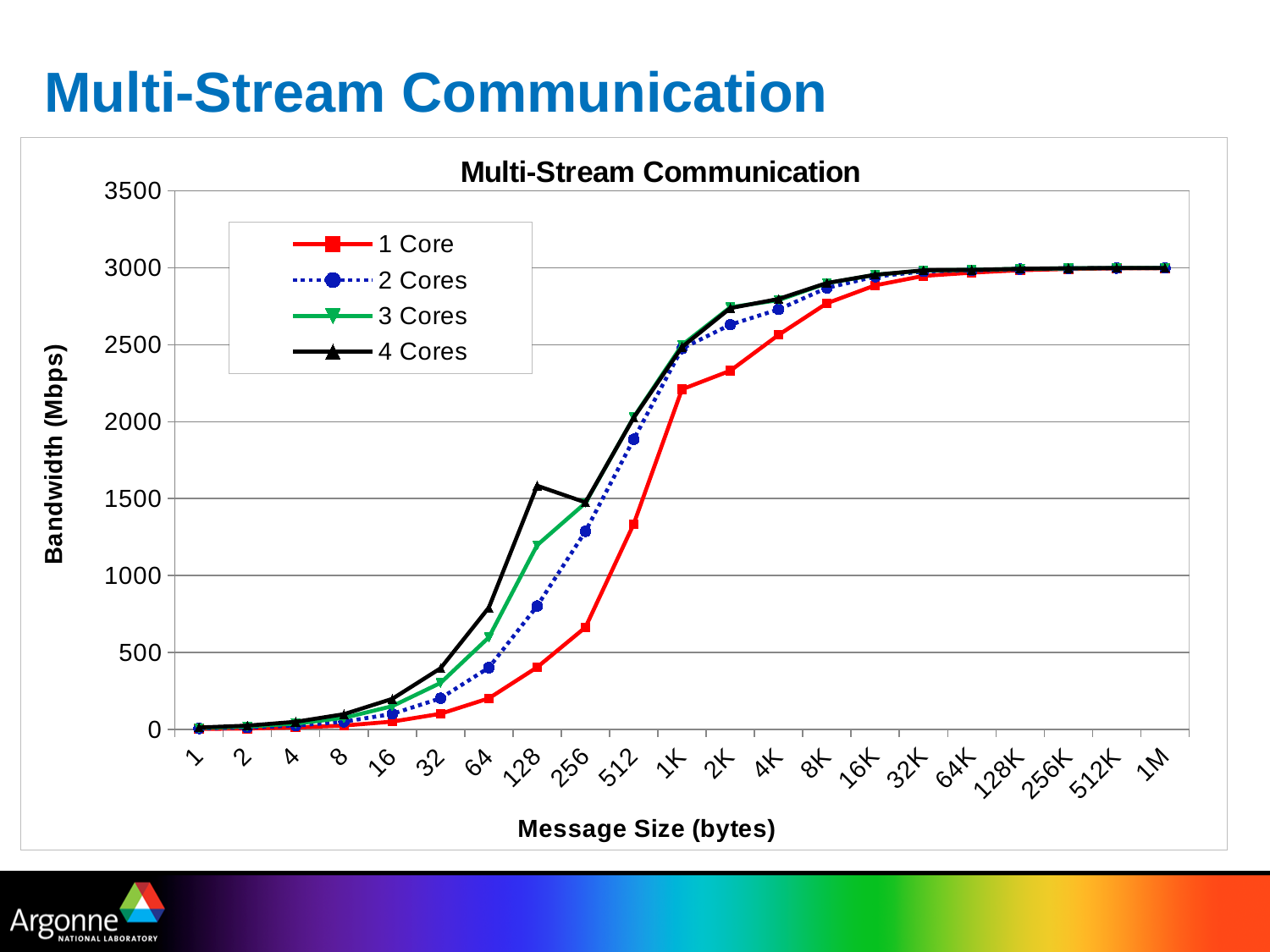
How many series does the legend list? 4 Is the bandwidth for 1 Core at message size 1K greater or less than 2000? greater Is the bandwidth for 1 Core at message size 128 greater or less than 500? less At message size 64, which series has the higher bandwidth, 3 Cores or 2 Cores? 3 Cores Does the bandwidth for 1 Core generally rise or fall as message size increases along the x axis? Rise What is the title of the y axis? Bandwidth (Mbps) Is the bandwidth for 2 Cores at message size 2K greater or less than 2500? greater At message size 128, which series has the higher bandwidth, 4 Cores or 1 Core? 4 Cores How many message sizes are shown along the x axis? 21 What kind of chart is shown on the slide? Line chart